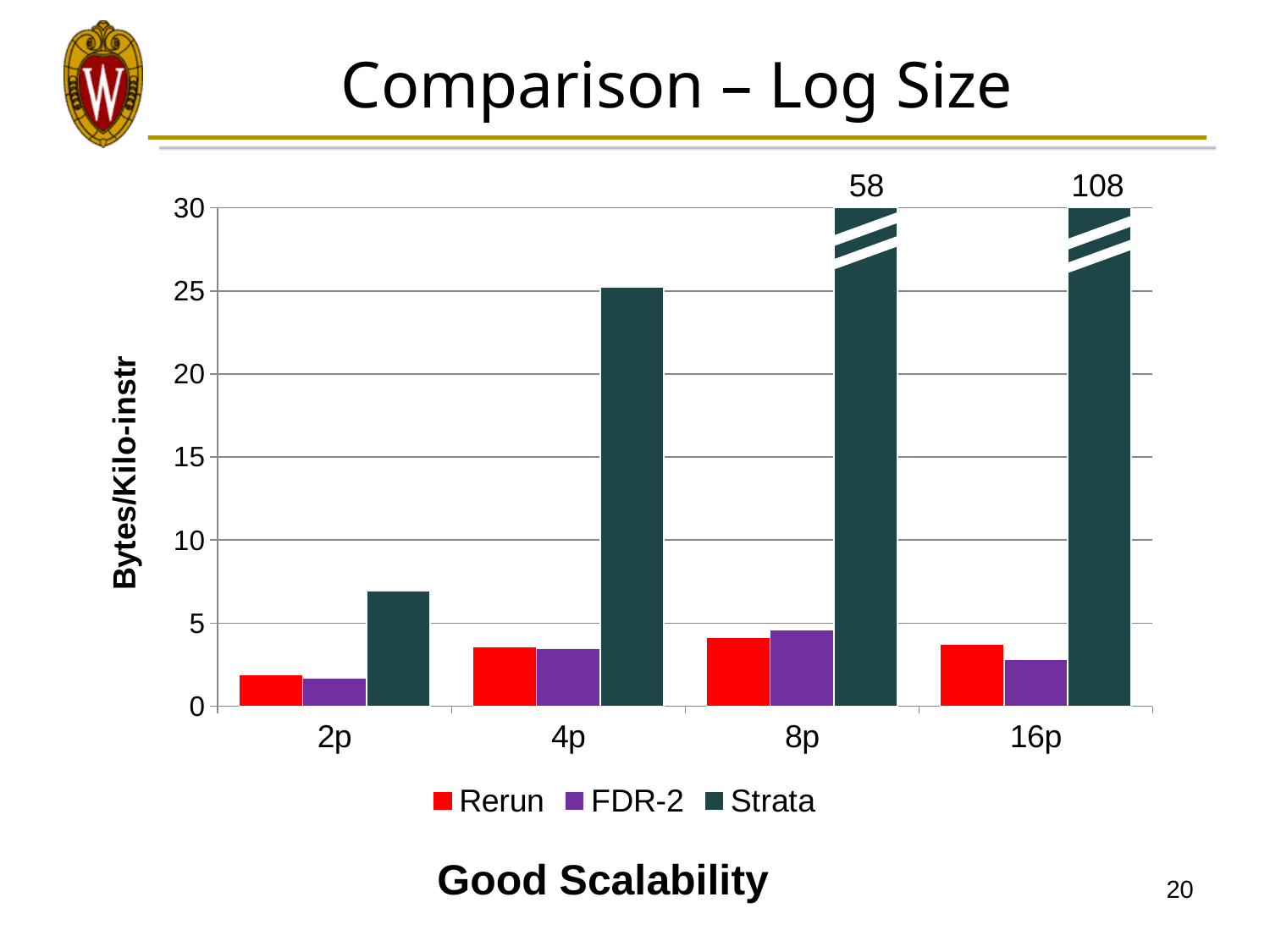
Which is larger at 16p, Rerun or FDR-2? Rerun Is the value for Strata at 4p greater or less than 20? greater Do the Strata values rise or fall from 2p to 16p? rise Which category has the highest Strata value? 16p Which series has the highest value at 4p? Strata Is the value for Strata at 2p greater or less than 5? greater What is the difference between the Strata values at 16p and 8p? 50 How many categories are shown on the x axis? 4 How many series does the legend list? 3 What is the value for Strata at 8p? 58 What is the value for Strata at 16p? 108 Is the value for Rerun at 2p greater or less than 5? less